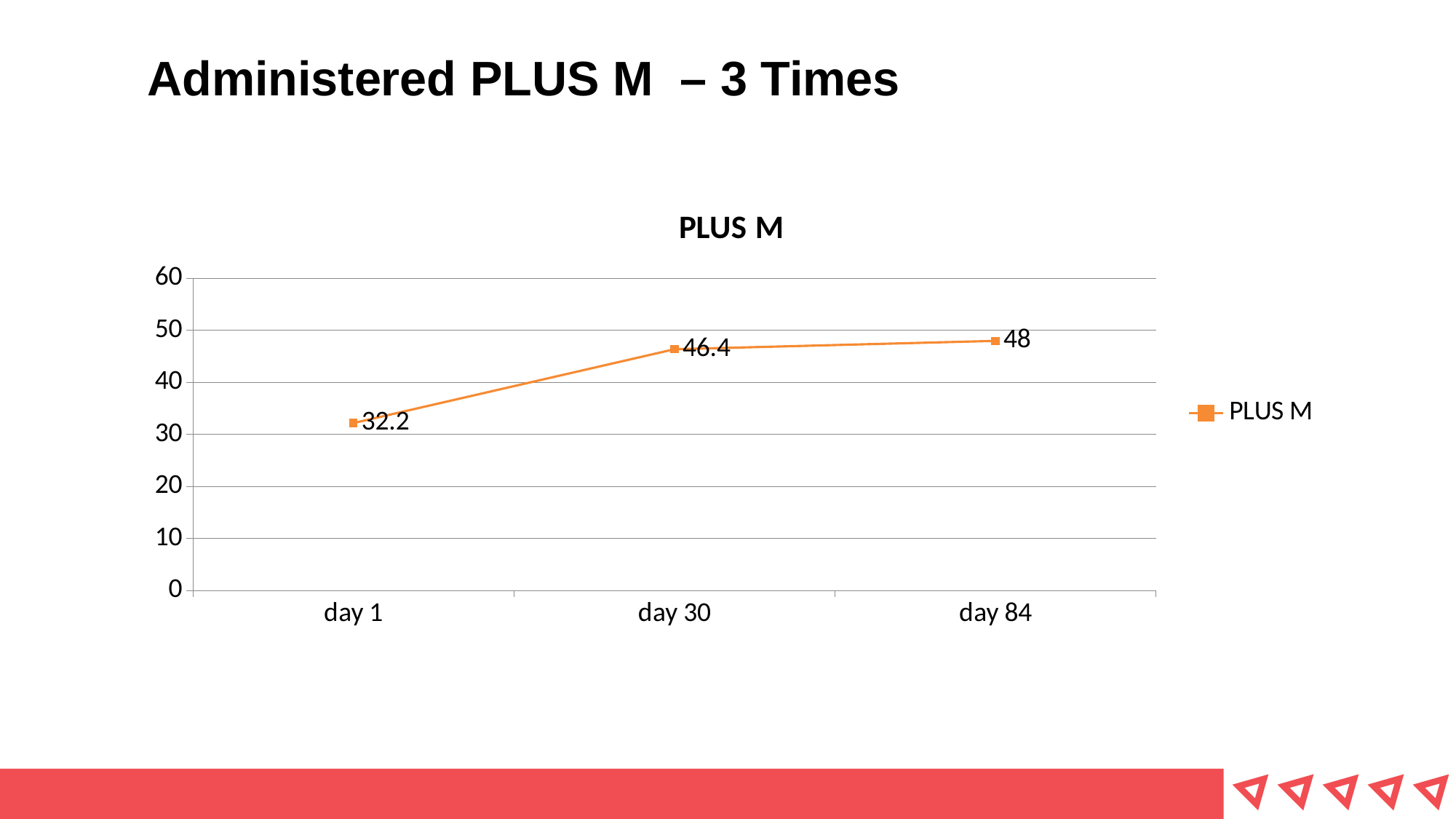
How many data points are plotted on the chart? 3 Which category has the lowest value? day 1 What is the value for day 1? 32.2 What kind of chart is shown on the slide? line chart Which is larger, the value for day 1 or the value for day 30? day 30 Which category has the highest value? day 84 Is the value for day 1 greater or less than 40? less What is the value for day 84? 48 Do the values rise or fall from day 1 to day 84? rise What is the difference between the values for day 84 and day 30? 1.6 What is the value for day 30? 46.4 What is the difference between the values for day 30 and day 1? 14.2